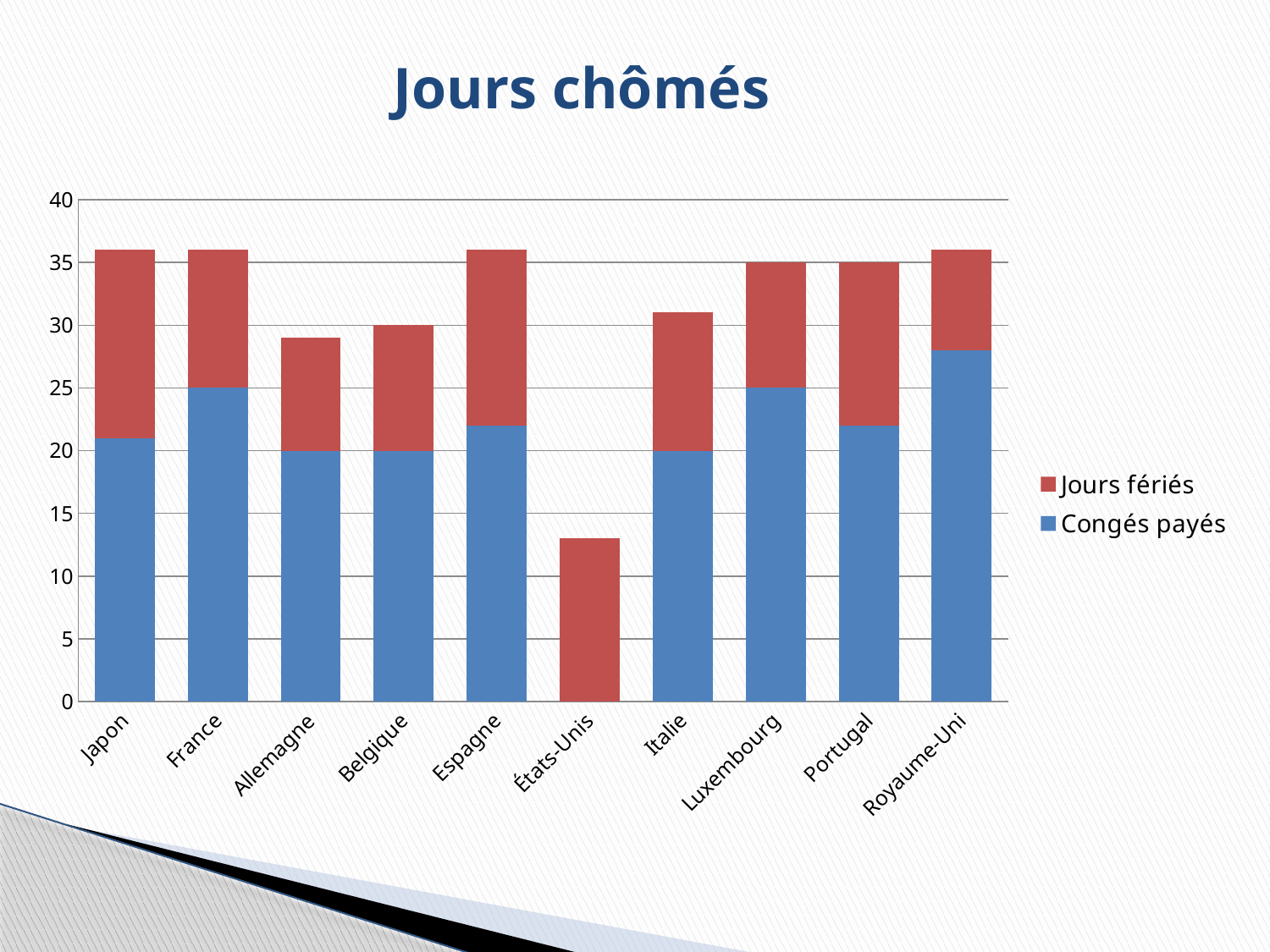
What kind of chart is shown on the slide? stacked bar chart Which country has the lowest total number of days in the chart? États-Unis What is the total height of the stacked bar for Belgique? 30 What is the value of Congés payés for France? 25 Which series is shown in blue according to the legend? Congés payés What is the total height of the stacked bar for Luxembourg? 35 How many countries are shown on the x axis of the chart? 10 How many series does the legend list? 2 Which country has the larger Congés payés value, Royaume-Uni or France? Royaume-Uni What is the title of the chart? Jours chômés Is the total value for États-Unis greater or less than 15? less Is the Congés payés value for Royaume-Uni greater or less than 25? greater